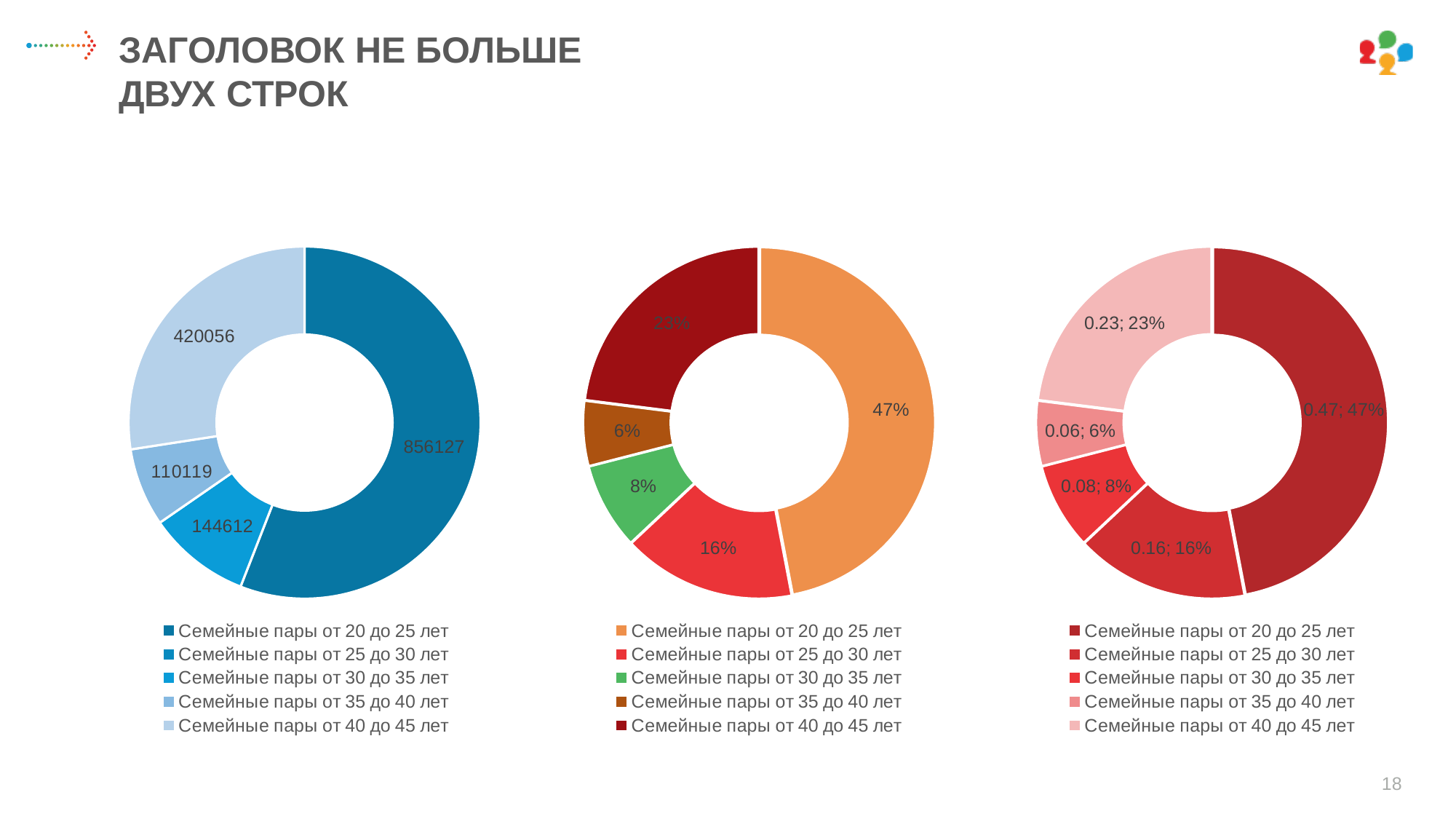
How many charts are shown on the slide? 3 In the middle chart, which is larger: Семейные пары от 25 до 30 лет or Семейные пары от 30 до 35 лет? Семейные пары от 25 до 30 лет In the middle chart, what share does Семейные пары от 40 до 45 лет have? 23% How many categories does the legend of the right chart list? 5 In the left chart, what is the difference between the values for Семейные пары от 30 до 35 лет and Семейные пары от 35 до 40 лет? 34493 In the left chart, which category has the largest slice? Семейные пары от 20 до 25 лет What kind of chart is the left chart on the slide? doughnut chart In the middle chart, which category has the smallest share? Семейные пары от 35 до 40 лет In the left chart, what is the value for Семейные пары от 30 до 35 лет? 144612 In the right chart, what is the data label shown for Семейные пары от 20 до 25 лет? 0.47; 47% In the left chart, what is the value for Семейные пары от 35 до 40 лет? 110119 In the left chart, what is the value for Семейные пары от 40 до 45 лет? 420056